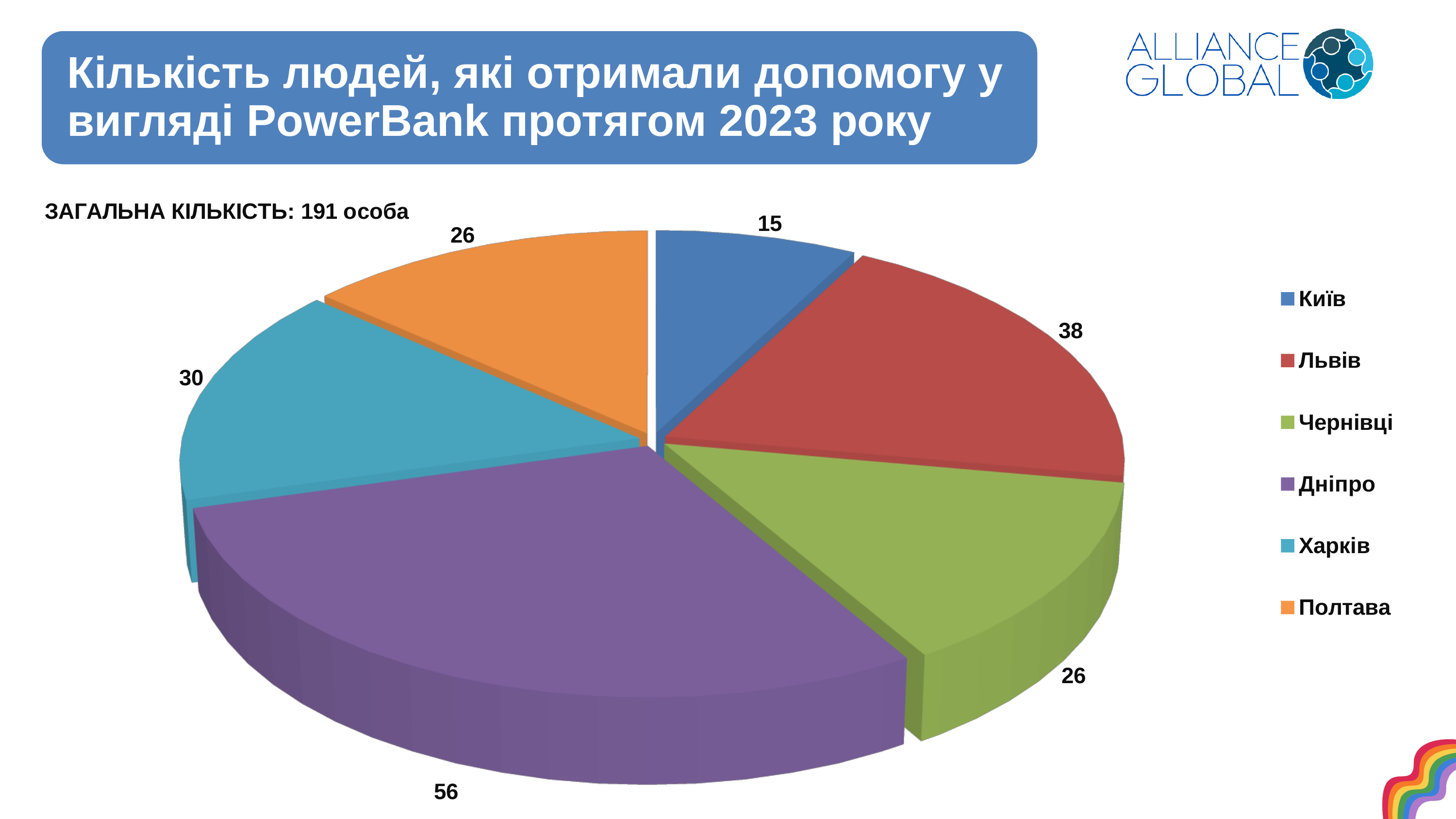
What kind of chart is shown on the slide? pie chart Which is larger, the value for Львів or the value for Харків? Львів What is the value for Львів? 38 How many cities are shown in the pie chart? 6 Which city has the largest slice of the pie? Дніпро What is the difference between the values for Дніпро and Львів? 18 What is the value for Харків? 30 What is the value for Київ? 15 What is the difference between the values for Харків and Київ? 15 How many people received a PowerBank in Дніпро? 56 What total number of people is stated on the slide? 191 особа Which city has the smallest slice of the pie? Київ